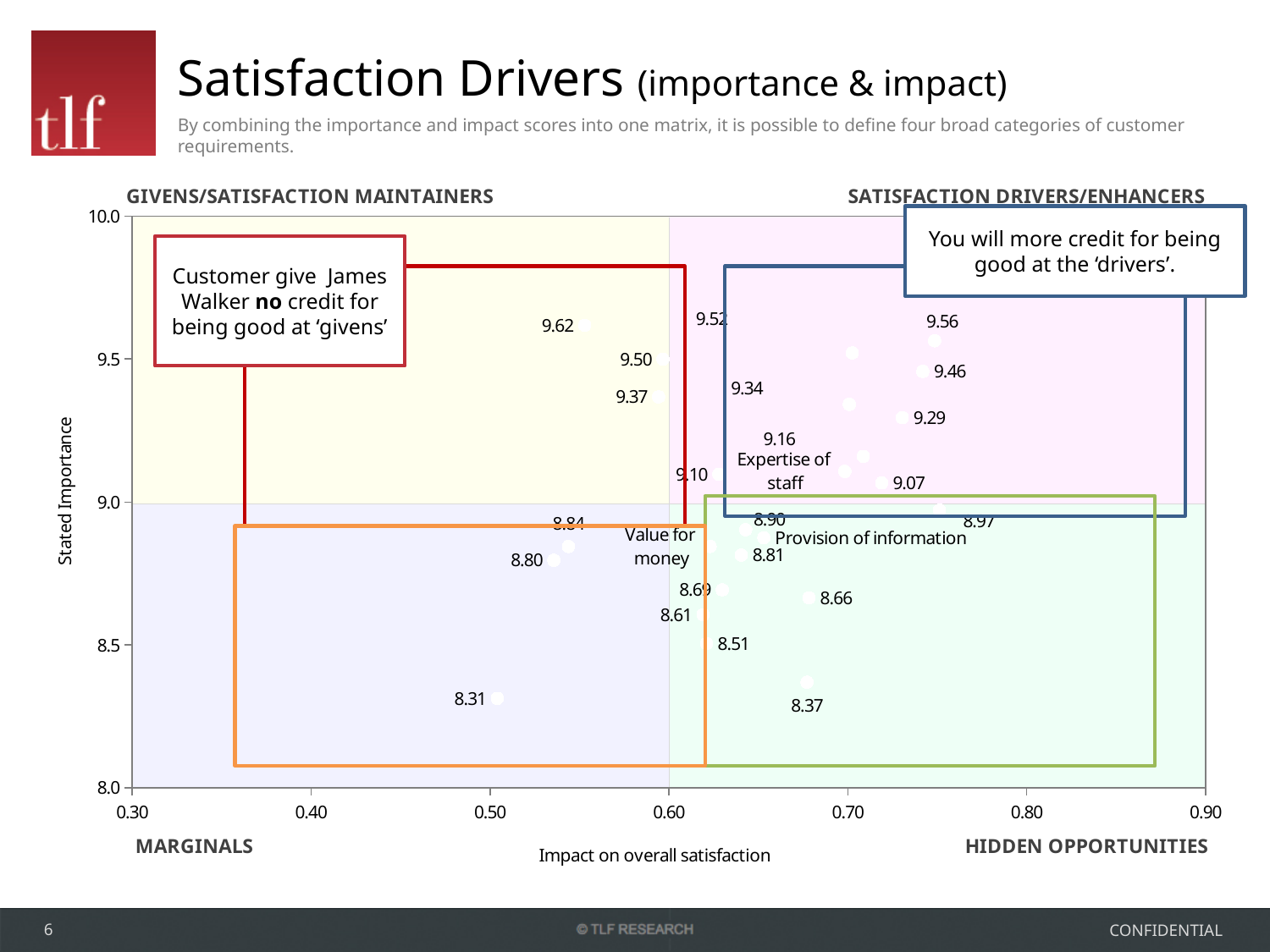
Is the stated importance for 'Expertise of staff' greater or less than 9.0? greater What is the lowest stated importance value labeled on the chart? 8.31 Is the point labeled 8.31 greater or less than 8.5 on the stated importance axis? less What is the difference between the highest labeled value (9.62) and the lowest labeled value (8.31)? 1.31 What is the highest stated importance value labeled on the chart? 9.62 What is the maximum value shown on the horizontal axis? 0.90 What is the title of the vertical axis? Stated Importance What label is given to the top-right quadrant of the chart? SATISFACTION DRIVERS/ENHANCERS What type of chart is shown on the slide? scatter chart Which is larger, the point labeled 9.34 or the point labeled 9.29? 9.34 Is the stated importance for 'Value for money' greater or less than 9.0? less What is the difference between the points labeled 9.56 and 9.46? 0.10